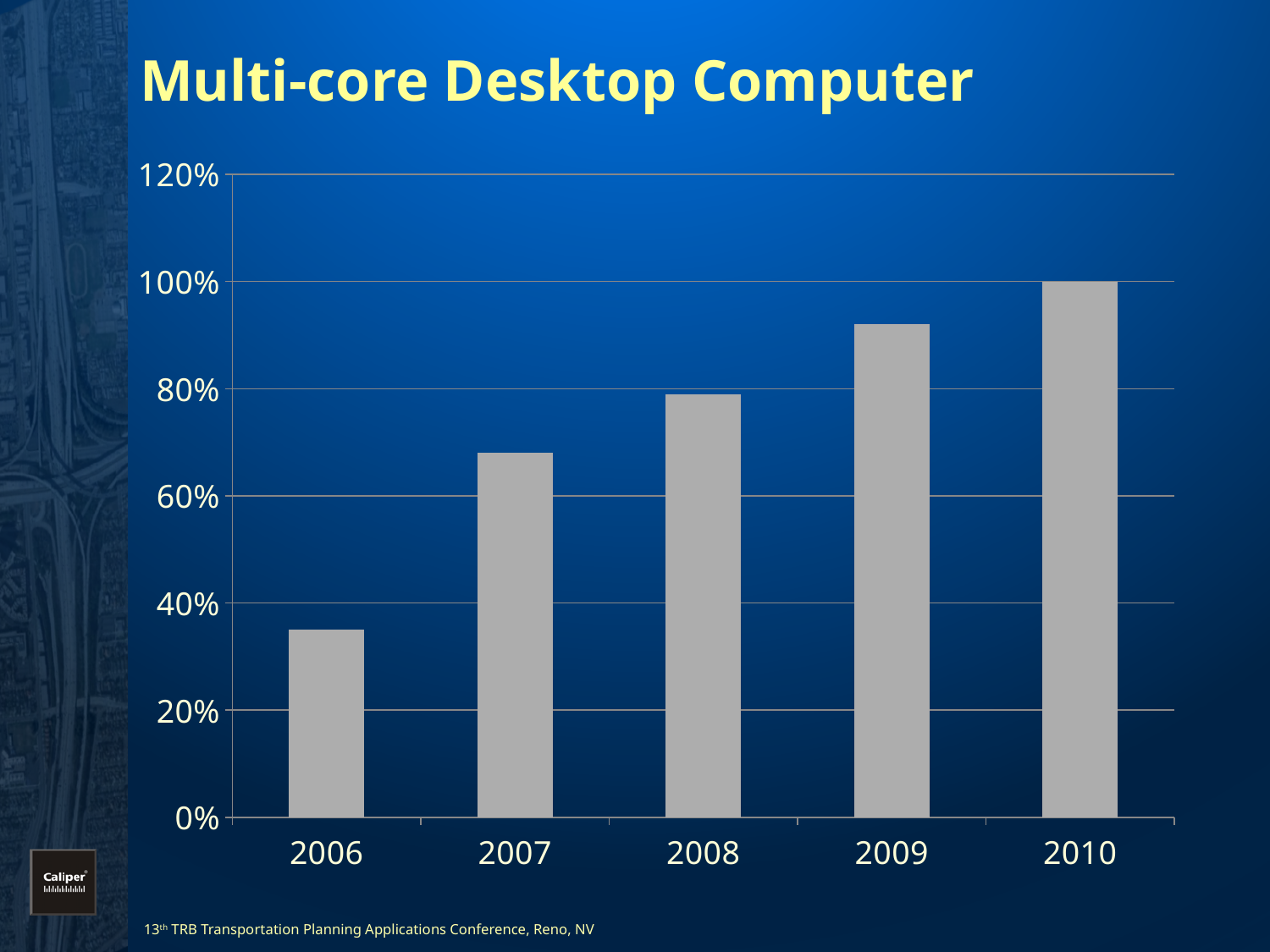
What is the title of the chart? Multi-core Desktop Computer Which is larger, the value for 2007 or the value for 2008? 2008 Is the value for 2009 greater or less than 80%? greater Is the value for 2007 greater or less than 60%? greater Which year has the highest value? 2010 Is the value for 2006 greater or less than 40%? less What is the value for 2010? 100% Do the values rise or fall from 2006 to 2010? rise Which year has the lowest value? 2006 How many years are shown on the x axis? 5 What kind of chart is shown on the slide? bar chart